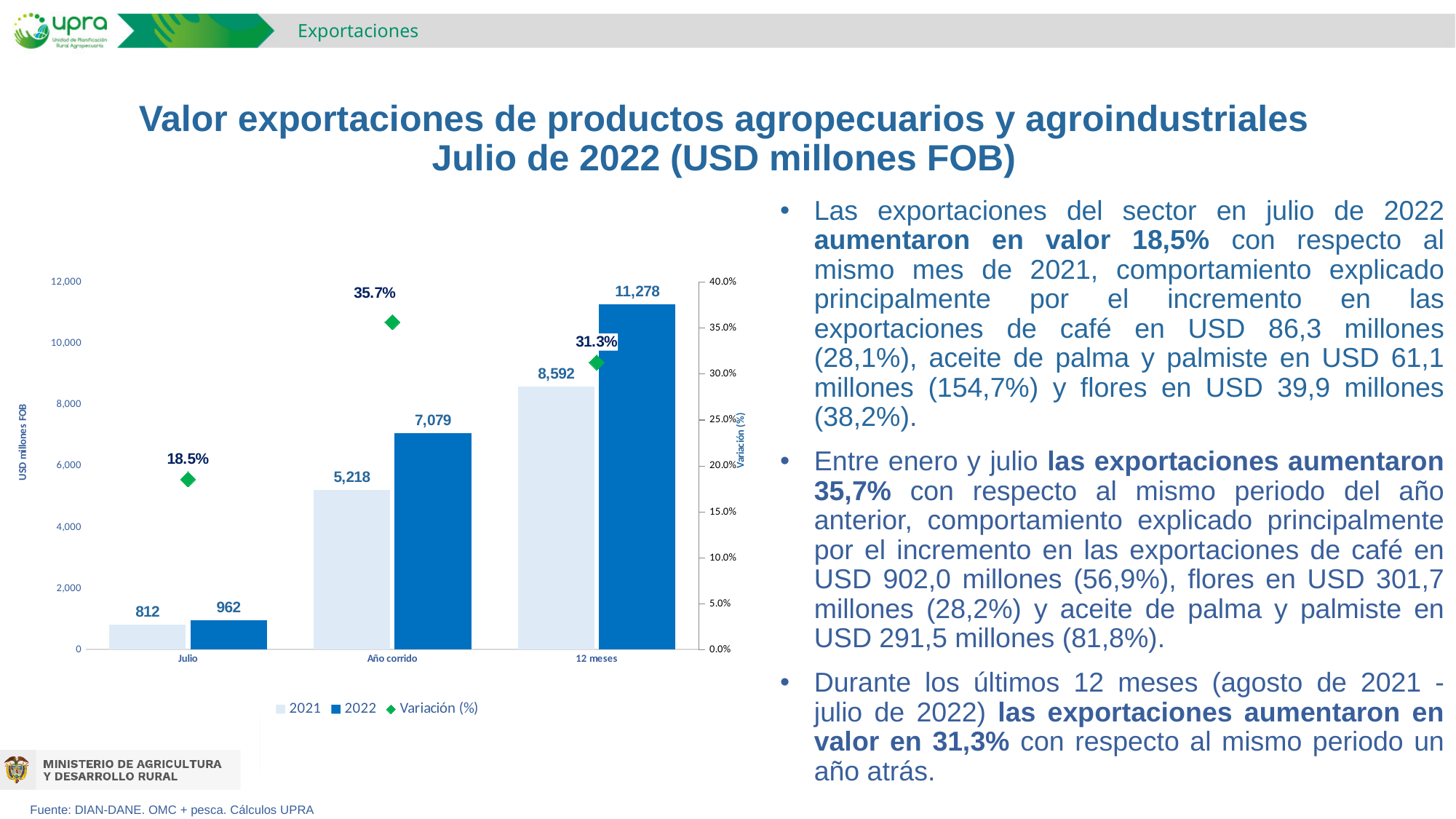
Which category has the lowest 2021 value? Julio What is the difference between the 2022 and 2021 values for Año corrido? 1,861 Which category has the highest Variación (%)? Año corrido What is the 2021 value for Año corrido? 5,218 What is the 2022 value for Julio? 962 Which is larger, the 2022 value for Año corrido or the 2021 value for 12 meses? 2021 value for 12 meses How many series does the legend list? 3 What is the difference between the 2022 and 2021 values for 12 meses? 2,686 What is the Variación (%) shown for 12 meses? 31.3% What kind of chart is used for the 2021 and 2022 values? Bar chart Which category has the highest 2022 value? 12 meses How many categories are shown on the x axis? 3